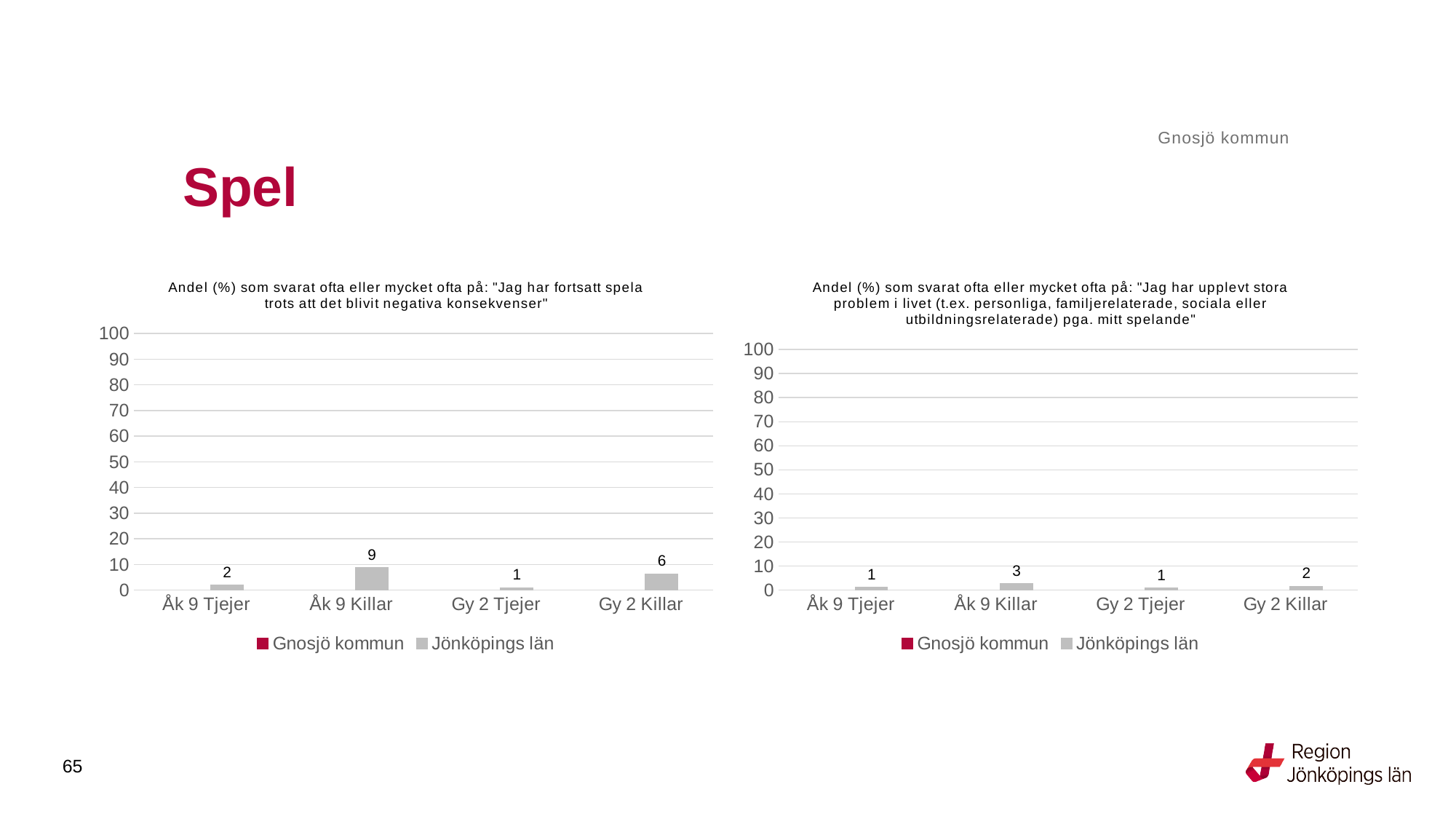
What kind of chart is the left chart? bar chart In the right chart ("Jag har upplevt stora problem i livet ... pga. mitt spelande"), what is the value for Jönköpings län for Gy 2 Killar? 2 In the right chart ("Jag har upplevt stora problem i livet ... pga. mitt spelande"), is the Jönköpings län value for Åk 9 Killar larger or smaller than for Gy 2 Killar? larger In the left chart ("Jag har fortsatt spela trots att det blivit negativa konsekvenser"), what is the value for Jönköpings län for Gy 2 Killar? 6 In the right chart ("Jag har upplevt stora problem i livet ... pga. mitt spelande"), what is the value for Jönköpings län for Åk 9 Killar? 3 How many categories are shown on the x axis of the left chart? 4 In the right chart ("Jag har upplevt stora problem i livet ... pga. mitt spelande"), which category has the highest Jönköpings län value? Åk 9 Killar In the left chart ("Jag har fortsatt spela trots att det blivit negativa konsekvenser"), what is the value for Jönköpings län for Åk 9 Killar? 9 In the left chart ("Jag har fortsatt spela trots att det blivit negativa konsekvenser"), which category has the highest Jönköpings län value? Åk 9 Killar In the left chart ("Jag har fortsatt spela trots att det blivit negativa konsekvenser"), what is the difference between the Jönköpings län values for Åk 9 Killar and Gy 2 Killar? 3 In the left chart ("Jag har fortsatt spela trots att det blivit negativa konsekvenser"), which category has the lowest Jönköpings län value? Gy 2 Tjejer How many series does the legend of the right chart list? 2